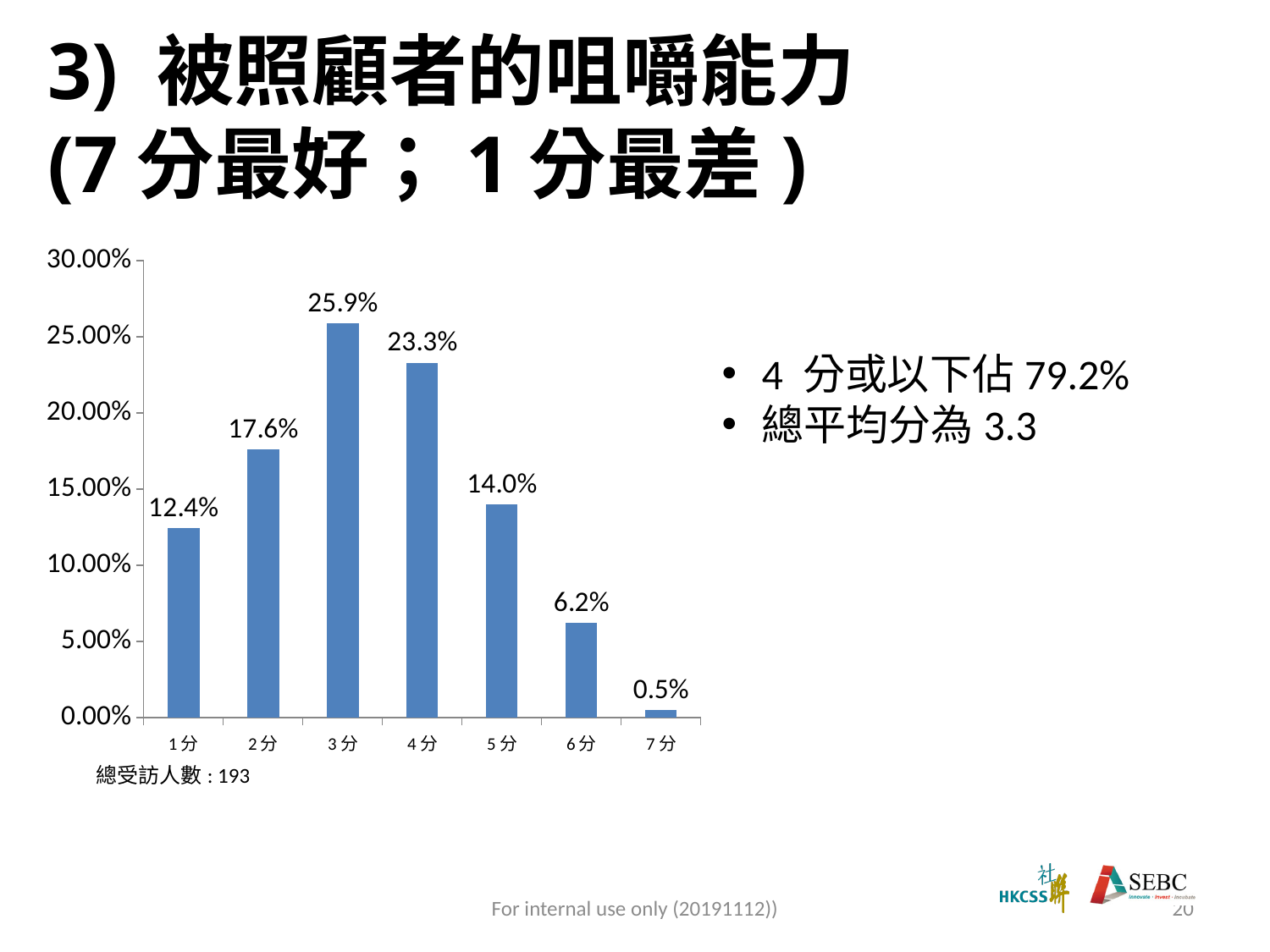
Which category has the lowest value? 7 分 Is the value for 6 分 greater or less than 10.00%? less Do the values rise or fall from 4 分 to 7 分? fall What is the total number of respondents stated below the chart? 193 What kind of chart is shown on the slide? bar chart What is the value for 7 分? 0.5% What is the value for 1 分? 12.4% Which category has the highest value? 3 分 How many categories are shown on the x axis? 7 What is the difference between the values for 3 分 and 4 分? 2.6% What is the value for 3 分? 25.9% Which is larger, the value for 2 分 or the value for 5 分? 2 分